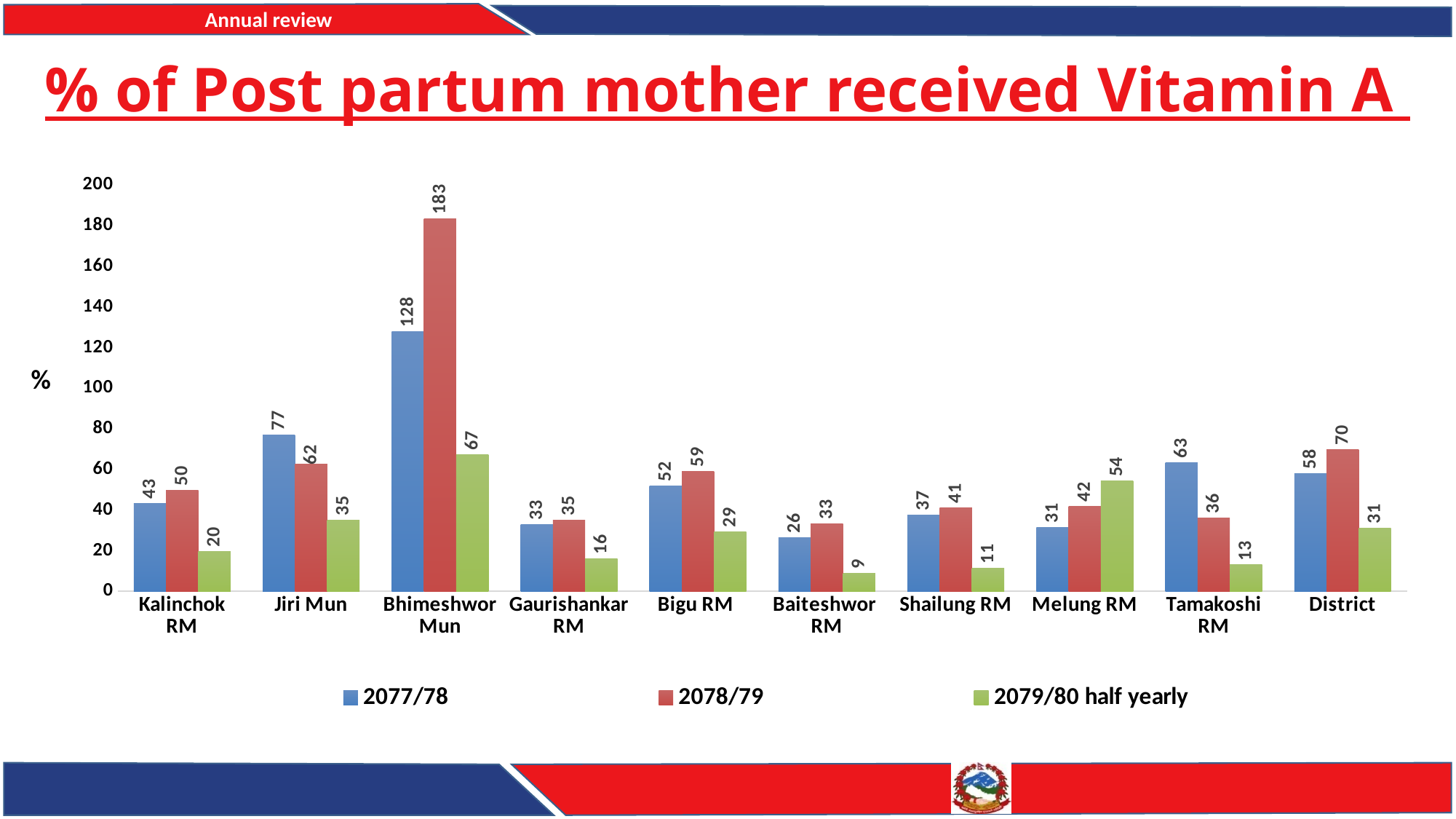
How many categories are shown on the x axis? 10 Is the 2078/79 value for Bhimeshwor Mun greater or less than 160? greater What kind of chart is shown on the slide? Bar chart Which is larger for Tamakoshi RM: the 2077/78 value or the 2078/79 value? 2077/78 What is the value for Bhimeshwor Mun in the 2078/79 series? 183 What is the District value for 2077/78? 58 Which category has the highest value in the 2077/78 series? Bhimeshwor Mun What is the title of the chart? % of Post partum mother received Vitamin A What is the difference between the 2078/79 and 2077/78 values for Jiri Mun? 15 What is the value for Melung RM in the 2079/80 half yearly series? 54 How many series does the legend list? 3 Which category has the lowest value in the 2079/80 half yearly series? Baiteshwor RM